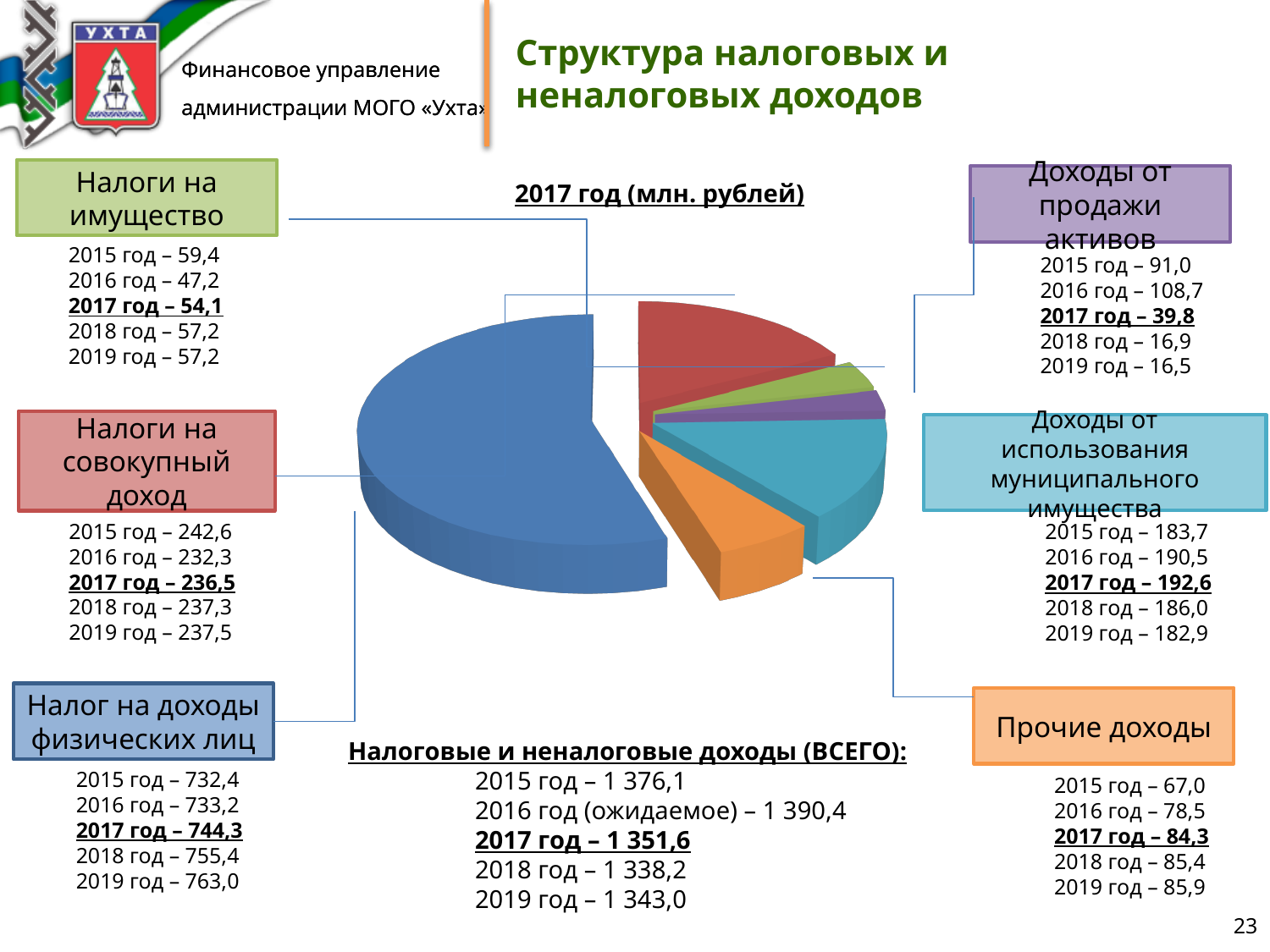
How many slices does the pie chart have? 6 What is the title printed above the pie chart? 2017 год (млн. рублей) What is the total of all 2017 revenue categories shown in the pie chart (Налоговые и неналоговые доходы ВСЕГО)? 1 351,6 What is the 2017 value for Доходы от использования муниципального имущества? 192,6 Which revenue category has the smallest slice in the 2017 pie chart? Доходы от продажи активов Which revenue category has the largest slice in the 2017 pie chart? Налог на доходы физических лиц What is the difference between the 2017 values for Налог на доходы физических лиц and Налоги на совокупный доход? 507,8 What kind of chart is shown on the slide? pie chart What is the 2017 value for Налоги на имущество? 54,1 Which is larger in 2017: Доходы от использования муниципального имущества or Налоги на совокупный доход? Налоги на совокупный доход What is the 2017 value for Прочие доходы? 84,3 What is the 2017 value for Налог на доходы физических лиц (млн. рублей)? 744,3